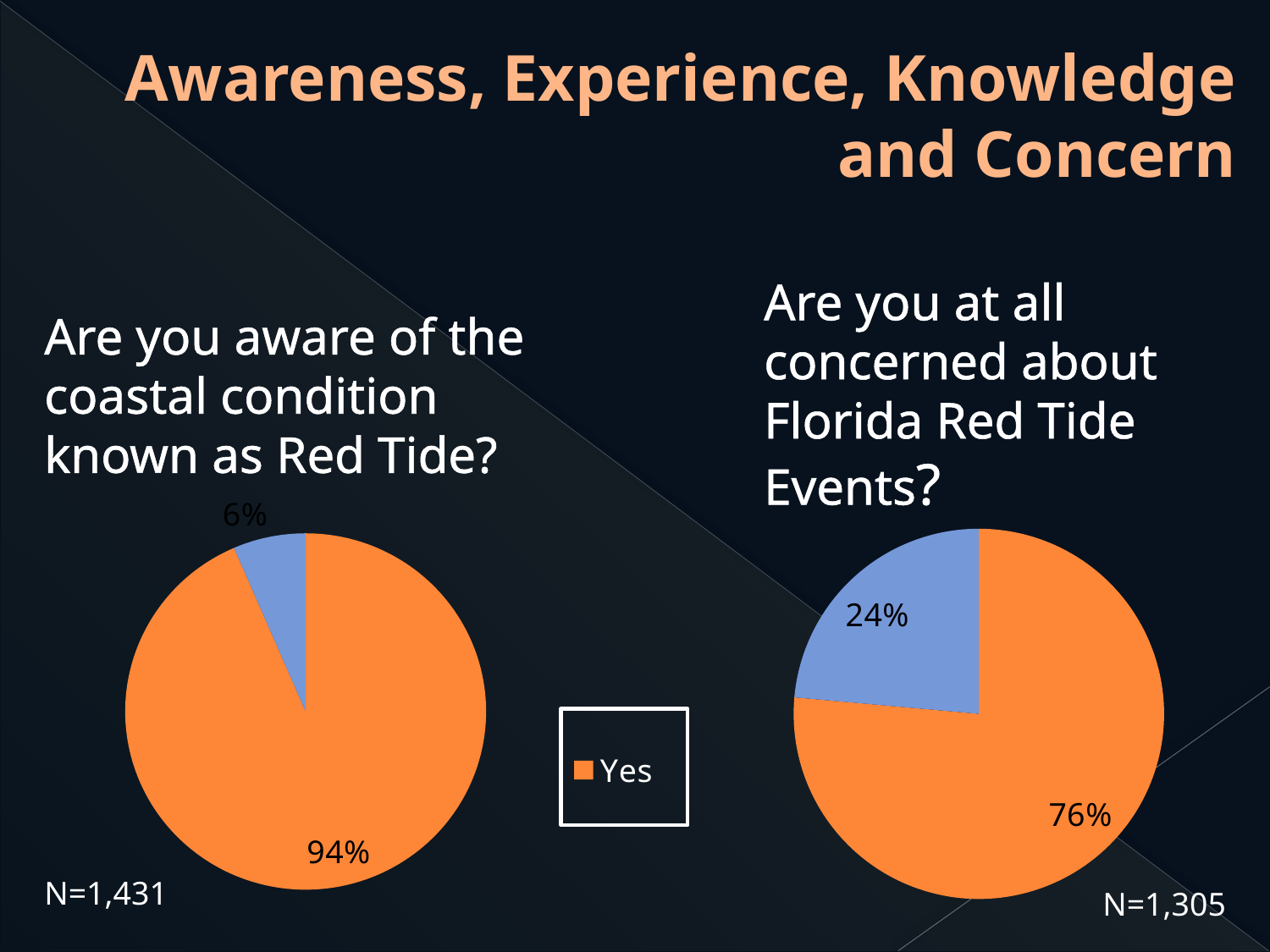
Which slice is larger in the right pie chart about concern over Florida Red Tide Events, the orange Yes slice or the blue slice? The orange Yes slice How many slices does the left pie chart about awareness of Red Tide have? 2 Which pie chart has the larger Yes share, the left one about awareness or the right one about concern? The left one about awareness In the right pie chart about concern over Florida Red Tide Events, what is the difference between the Yes slice and the blue slice? 52% In the left pie chart about awareness of Red Tide, what percentage does the blue slice represent? 6% What entry does the legend between the two pie charts list? Yes In the right pie chart about concern over Florida Red Tide Events, what percentage does the blue slice represent? 24% In the right pie chart about concern over Florida Red Tide Events, what share of respondents answered Yes? 76% What is the sample size (N) shown for the left pie chart about awareness of Red Tide? N=1,431 In the left pie chart about awareness of Red Tide, what share of respondents answered Yes? 94% What is the difference between the Yes share in the left pie chart (awareness) and the Yes share in the right pie chart (concern)? 18% What type of chart is used on this slide? Pie chart